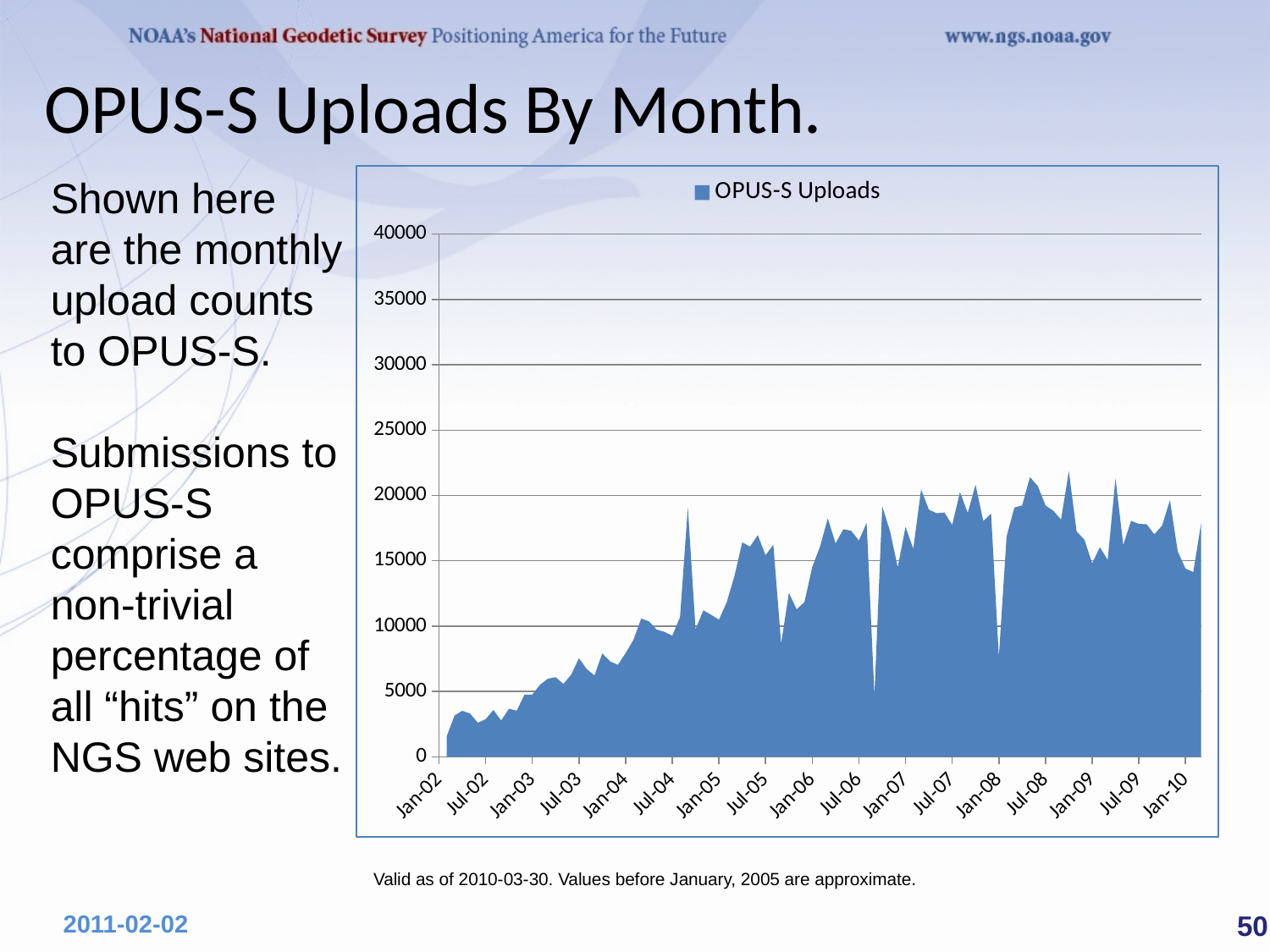
Do the monthly upload counts generally rise or fall from Jan-02 to Jan-10? rise Is the value for Jan-02 greater or less than 5000? less Is the value for Jul-08 greater or less than 15000? greater What is the name of the series shown in the legend? OPUS-S Uploads How many date labels are shown along the x axis? 17 Is the value for Jul-05 greater or less than 15000? greater What kind of chart is shown on the slide? area chart What is the highest value shown on the vertical axis? 40000 How many series does the legend list? 1 Which is larger, the value for Jan-02 or the value for Jan-07? Jan-07